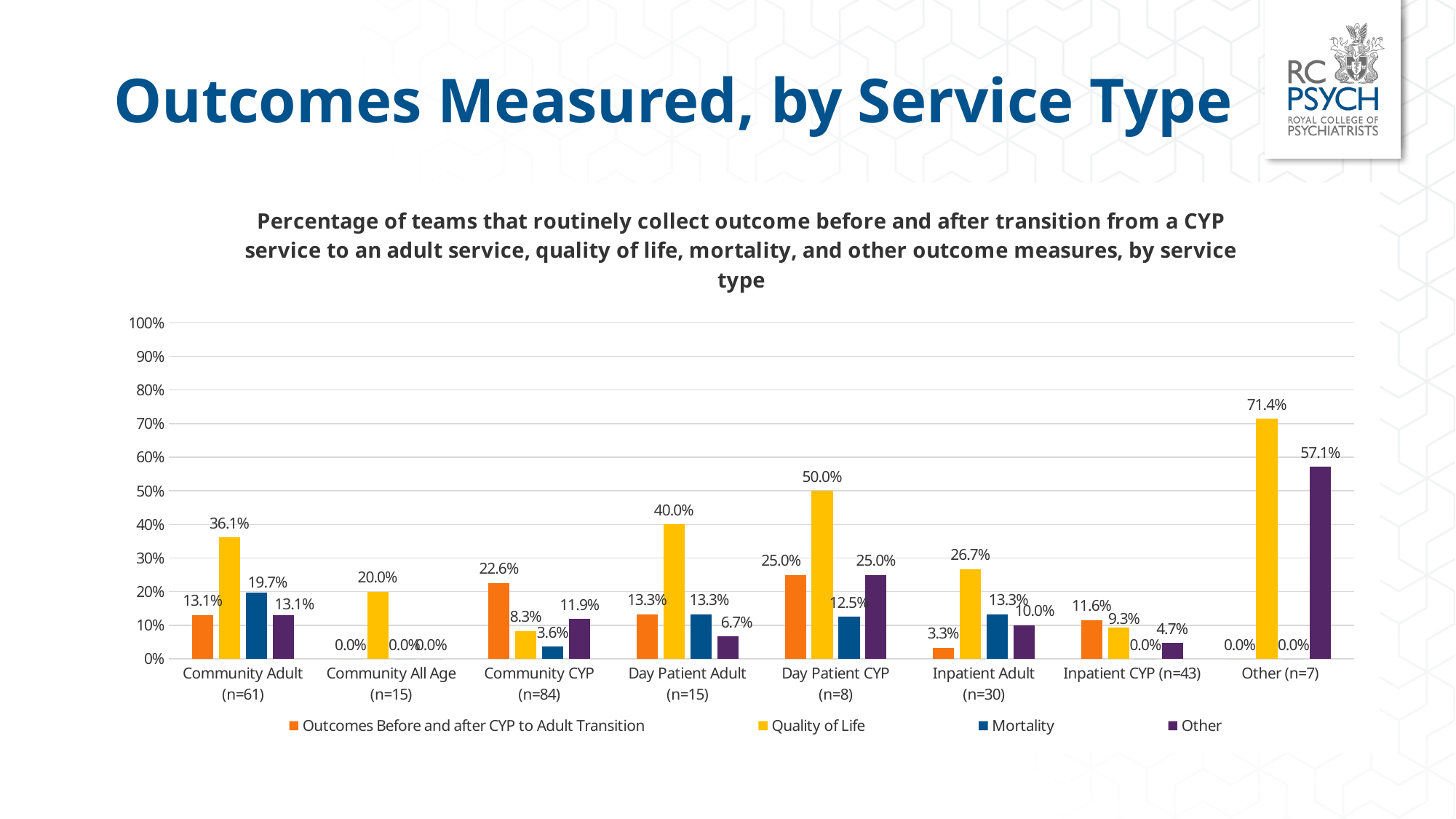
What is the Outcomes Before and after CYP to Adult Transition value for Community CYP (n=84)? 22.6% How many series does the legend list? 4 What is the Quality of Life value for Community Adult (n=61)? 36.1% What is the difference between the Quality of Life value and the Other value for Other (n=7)? 14.3% Which service type has the highest Quality of Life value? Other (n=7) Which colour represents the Mortality series in the legend? blue Which service type has the lowest Other value? Community All Age (n=15) What type of chart is shown on the slide? bar chart How many service type categories are shown on the x axis? 8 What is the Mortality value for Day Patient CYP (n=8)? 12.5% Is the Quality of Life value for Day Patient Adult (n=15) greater or less than 30%? greater Which is larger for Inpatient CYP (n=43): the Outcomes Before and after CYP to Adult Transition value or the Quality of Life value? Outcomes Before and after CYP to Adult Transition